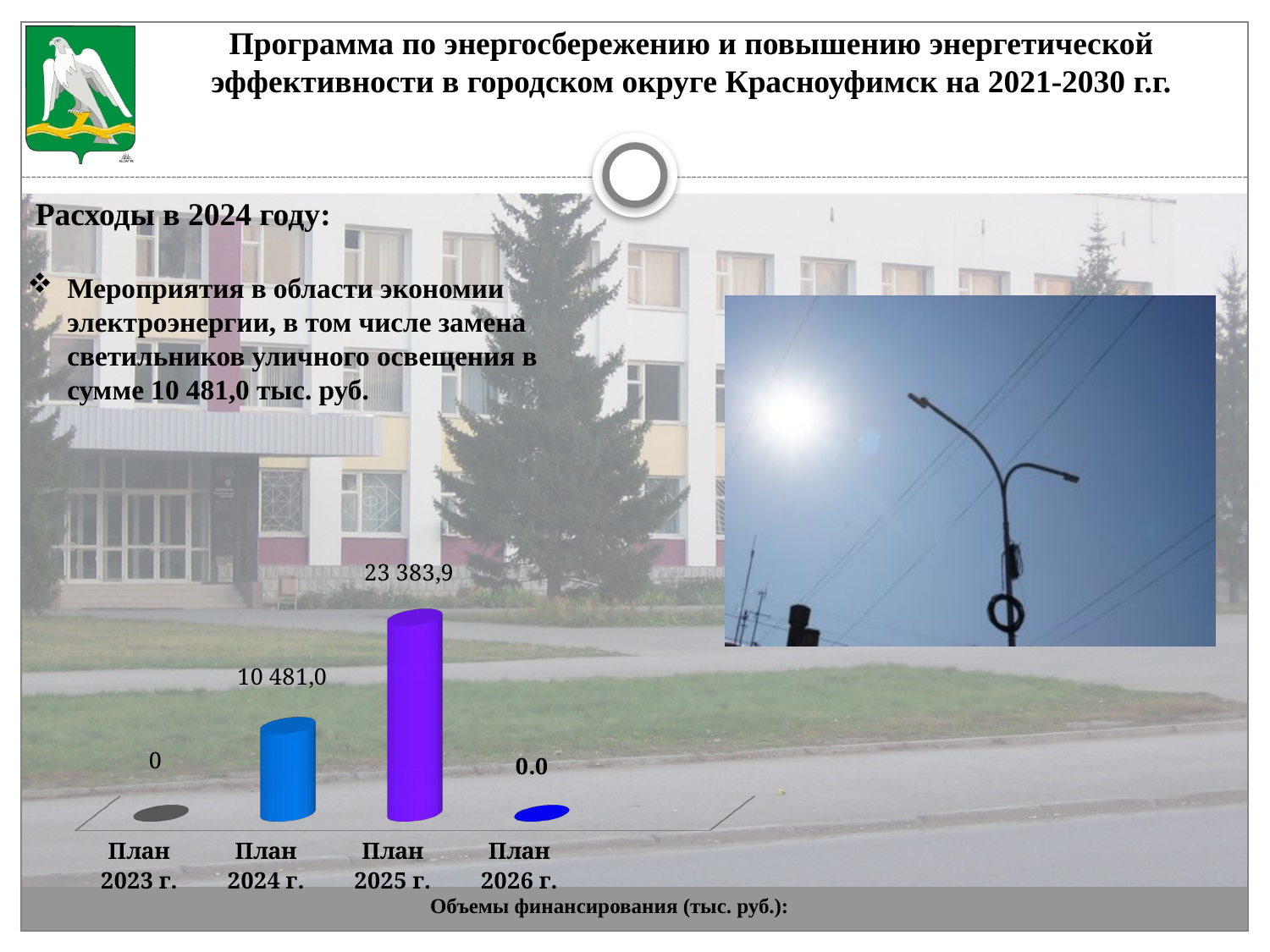
How many categories are shown on the chart? 4 What is the value for План 2023 г.? 0 What is the value for План 2025 г.? 23 383,9 What is the difference between the values for План 2025 г. and План 2024 г.? 12 902,9 What is the value for План 2024 г.? 10 481,0 Which category has the highest value? План 2025 г. Does the value rise or fall from План 2024 г. to План 2025 г.? Rise Which is larger, the value for План 2024 г. or the value for План 2025 г.? План 2025 г. What caption is shown below the chart? Объемы финансирования (тыс. руб.): What colour is the bar for План 2025 г.? Purple What kind of chart is shown on the slide? Bar chart What is the value for План 2026 г.? 0.0